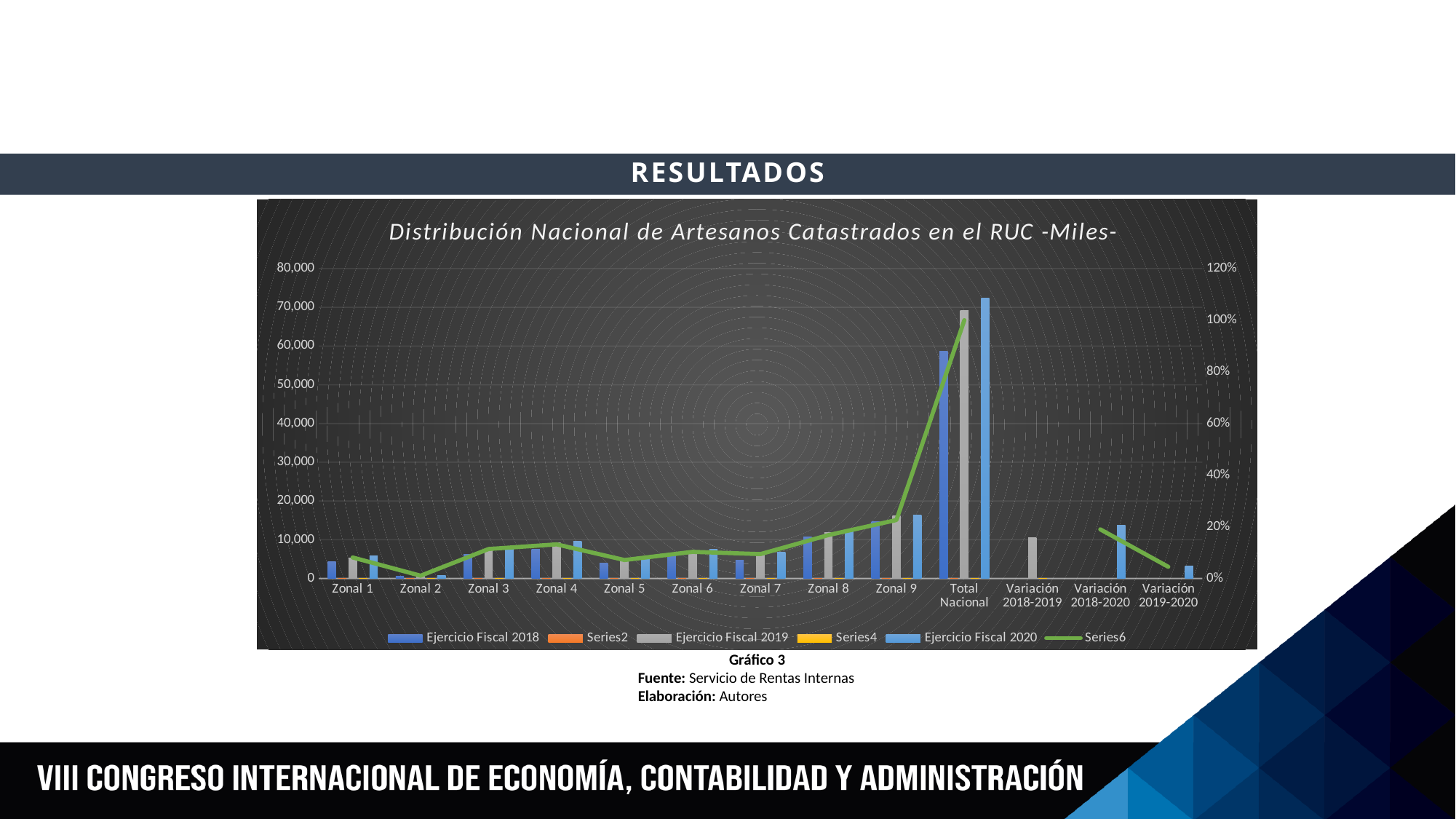
What kind of chart is this? Bar chart combined with a line Is the Ejercicio Fiscal 2020 value for Total Nacional greater or less than 60,000? greater What is the title of the chart? Distribución Nacional de Artesanos Catastrados en el RUC -Miles- Does the Series6 line generally rise or fall from Zonal 1 to Total Nacional? rise Is the Ejercicio Fiscal 2019 value for Zonal 2 greater or less than 10,000? less Among the Zonal 1 to Zonal 9 categories, which has the lowest Ejercicio Fiscal 2020 bar? Zonal 2 Which category has the tallest bar for Ejercicio Fiscal 2020? Total Nacional Is the Ejercicio Fiscal 2020 value for Zonal 9 greater or less than 10,000? greater How many entries does the chart legend list? 6 How many categories are shown along the x axis of the chart? 13 Which has the larger Ejercicio Fiscal 2020 bar, Zonal 4 or Zonal 5? Zonal 4